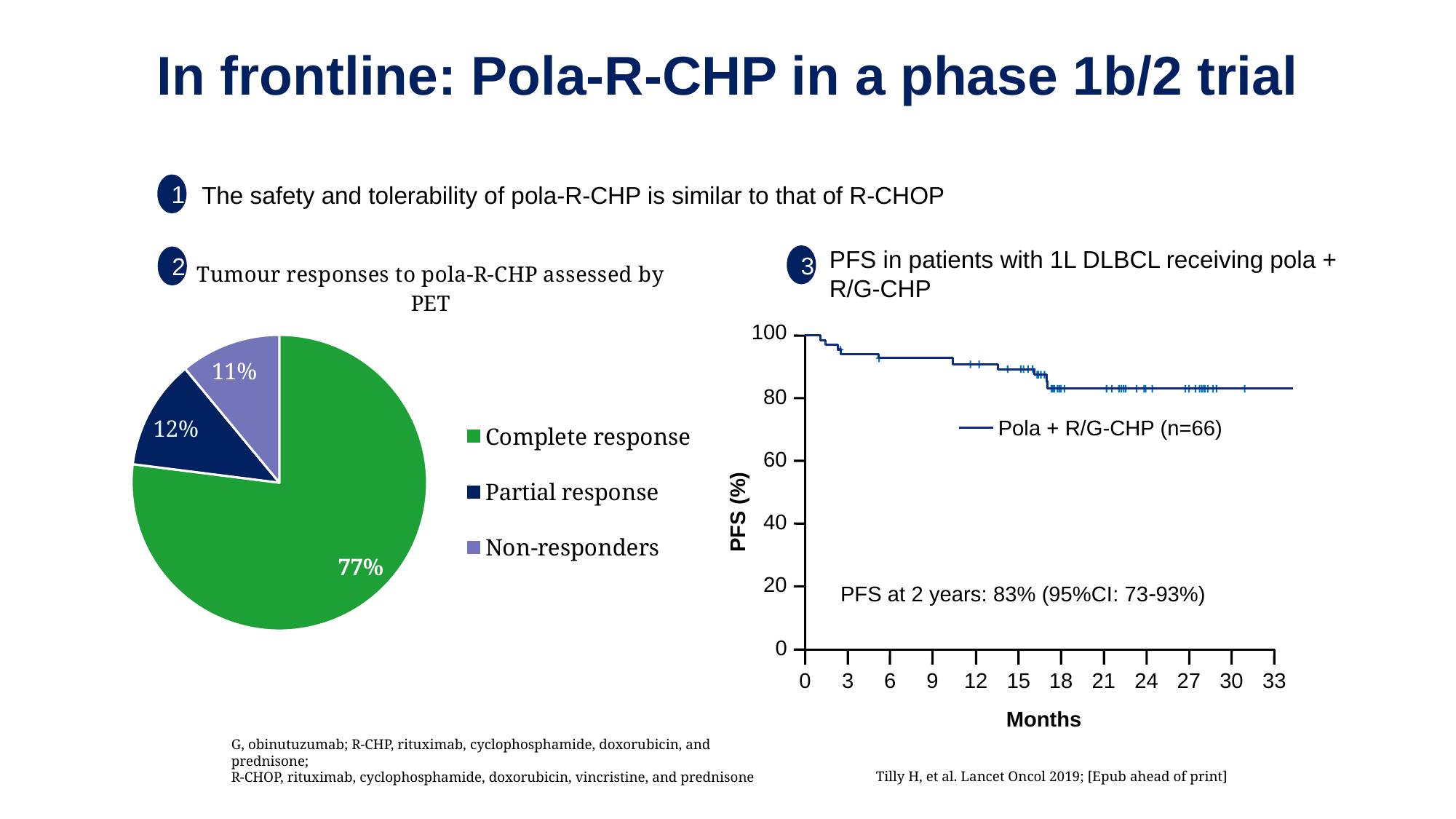
In the pie chart 'Tumour responses to pola-R-CHP assessed by PET', what share is Complete response? 77% In the pie chart 'Tumour responses to pola-R-CHP assessed by PET', what share is Non-responders? 11% What kind of chart is the 'Tumour responses to pola-R-CHP assessed by PET' chart? Pie chart In the pie chart 'Tumour responses to pola-R-CHP assessed by PET', how many categories are shown? 3 In the PFS chart on the right, does the PFS curve rise or fall as months increase? Fall In the pie chart 'Tumour responses to pola-R-CHP assessed by PET', which category has the largest slice? Complete response In the pie chart 'Tumour responses to pola-R-CHP assessed by PET', what share is Partial response? 12% In the PFS chart on the right, what is the PFS at 2 years as printed on the chart? 83% In the pie chart 'Tumour responses to pola-R-CHP assessed by PET', which category has the smallest slice? Non-responders In the PFS chart on the right, how many series does the legend list? 1 In the pie chart 'Tumour responses to pola-R-CHP assessed by PET', what colour is the Complete response slice? Green In the pie chart 'Tumour responses to pola-R-CHP assessed by PET', what is the difference in percentage points between Complete response and Partial response? 65